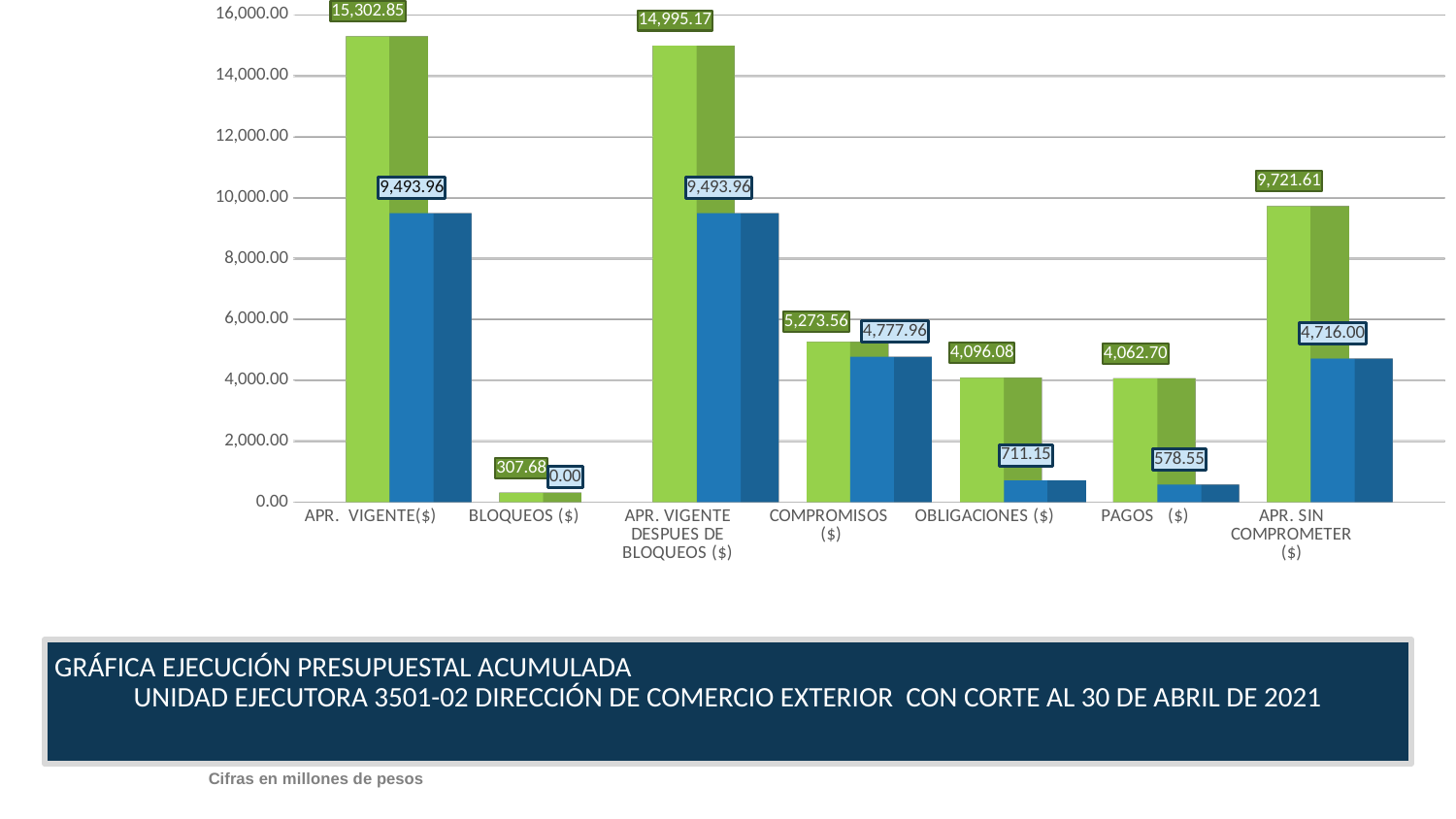
What is the value of the blue bar for PAGOS ($)? 578.55 Which is larger for OBLIGACIONES ($): the green bar or the blue bar? the green bar What is the value of the green bar for APR. VIGENTE($)? 15,302.85 How many categories are shown on the x axis? 7 What is the difference between the green bar and the blue bar for COMPROMISOS ($)? 495.60 What is the value of the blue bar for APR. VIGENTE($)? 9,493.96 Which category has the lowest blue bar? BLOQUEOS ($) What is the value of the green bar for APR. SIN COMPROMETER ($)? 9,721.61 What is the value of the green bar for BLOQUEOS ($)? 307.68 What unit note is printed below the chart? Cifras en millones de pesos What kind of chart is shown on the slide? bar chart Which category has the highest green bar? APR. VIGENTE($)